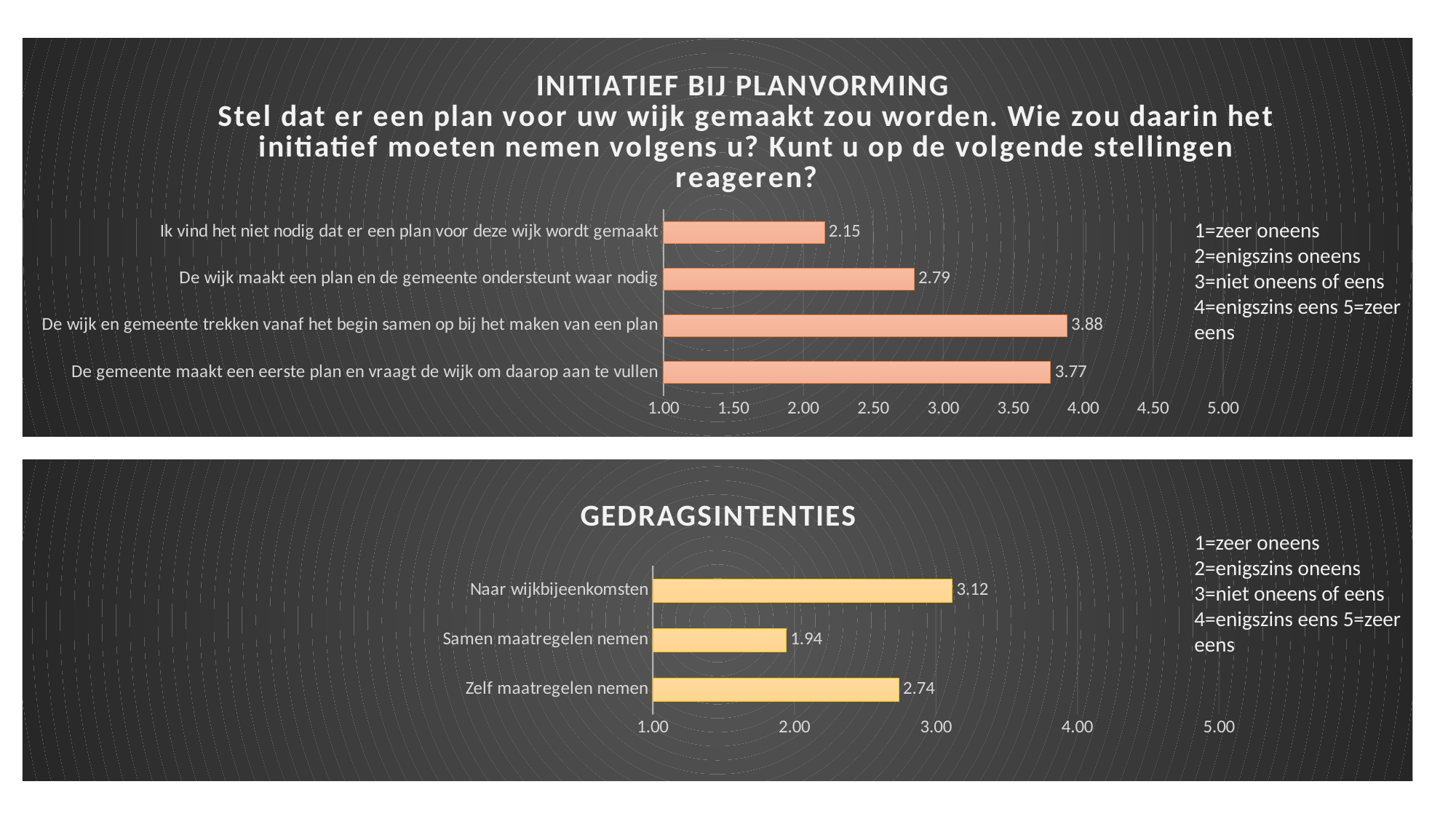
In the 'GEDRAGSINTENTIES' chart, which is larger: the value for 'Zelf maatregelen nemen' or 'Samen maatregelen nemen'? Zelf maatregelen nemen In the 'INITIATIEF BIJ PLANVORMING' chart, is the value for 'De wijk maakt een plan en de gemeente ondersteunt waar nodig' greater or less than 3.00? less In the 'INITIATIEF BIJ PLANVORMING' chart, which statement has the lowest value? Ik vind het niet nodig dat er een plan voor deze wijk wordt gemaakt In the 'GEDRAGSINTENTIES' chart, what is the value for 'Naar wijkbijeenkomsten'? 3.12 In the 'GEDRAGSINTENTIES' chart, which category has the highest value? Naar wijkbijeenkomsten In the 'INITIATIEF BIJ PLANVORMING' chart, what is the value for 'De wijk en gemeente trekken vanaf het begin samen op bij het maken van een plan'? 3.88 In the 'INITIATIEF BIJ PLANVORMING' chart, how many statements are plotted? 4 In the 'INITIATIEF BIJ PLANVORMING' chart, what is the difference between the values for 'De wijk en gemeente trekken vanaf het begin samen op bij het maken van een plan' and 'De gemeente maakt een eerste plan en vraagt de wijk om daarop aan te vullen'? 0.11 In the 'GEDRAGSINTENTIES' chart, what is the difference between the values for 'Zelf maatregelen nemen' and 'Samen maatregelen nemen'? 0.80 In the 'GEDRAGSINTENTIES' chart, what is the value for 'Samen maatregelen nemen'? 1.94 What kind of chart is the 'GEDRAGSINTENTIES' chart? Bar chart In the 'INITIATIEF BIJ PLANVORMING' chart, what is the value for 'Ik vind het niet nodig dat er een plan voor deze wijk wordt gemaakt'? 2.15